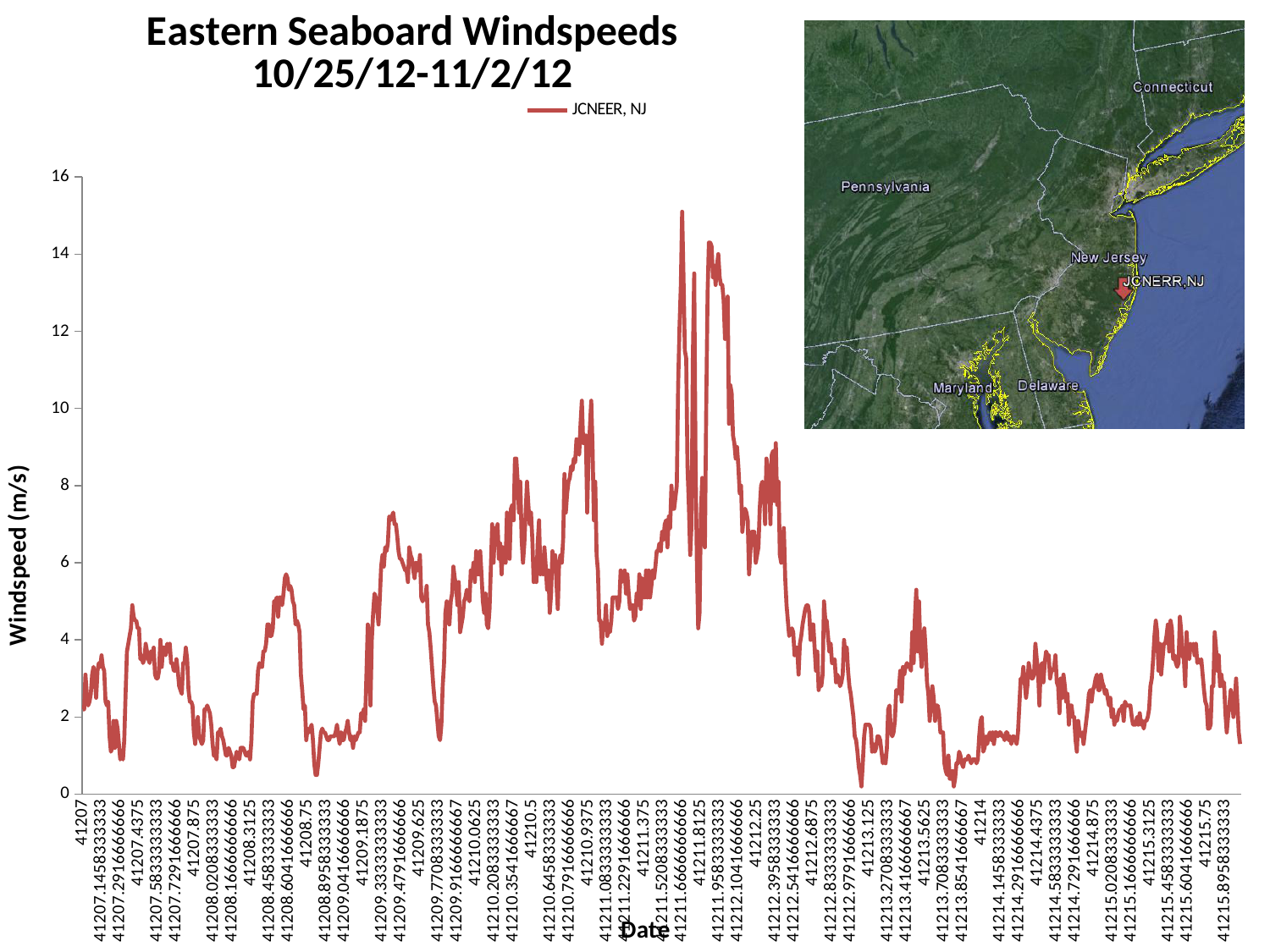
What kind of chart is shown on the slide? line chart What is the title of the chart? Eastern Seaboard Windspeeds 10/25/12-11/2/12 Is the windspeed value at the first point on the chart (41207) greater or less than 4? less Is the windspeed near 41213.125 greater or less than 2? less How many series does the chart legend list? 1 Is the peak windspeed near 41211.8125 greater or less than 12? greater What is the name of the series shown in the chart legend? JCNEER, NJ